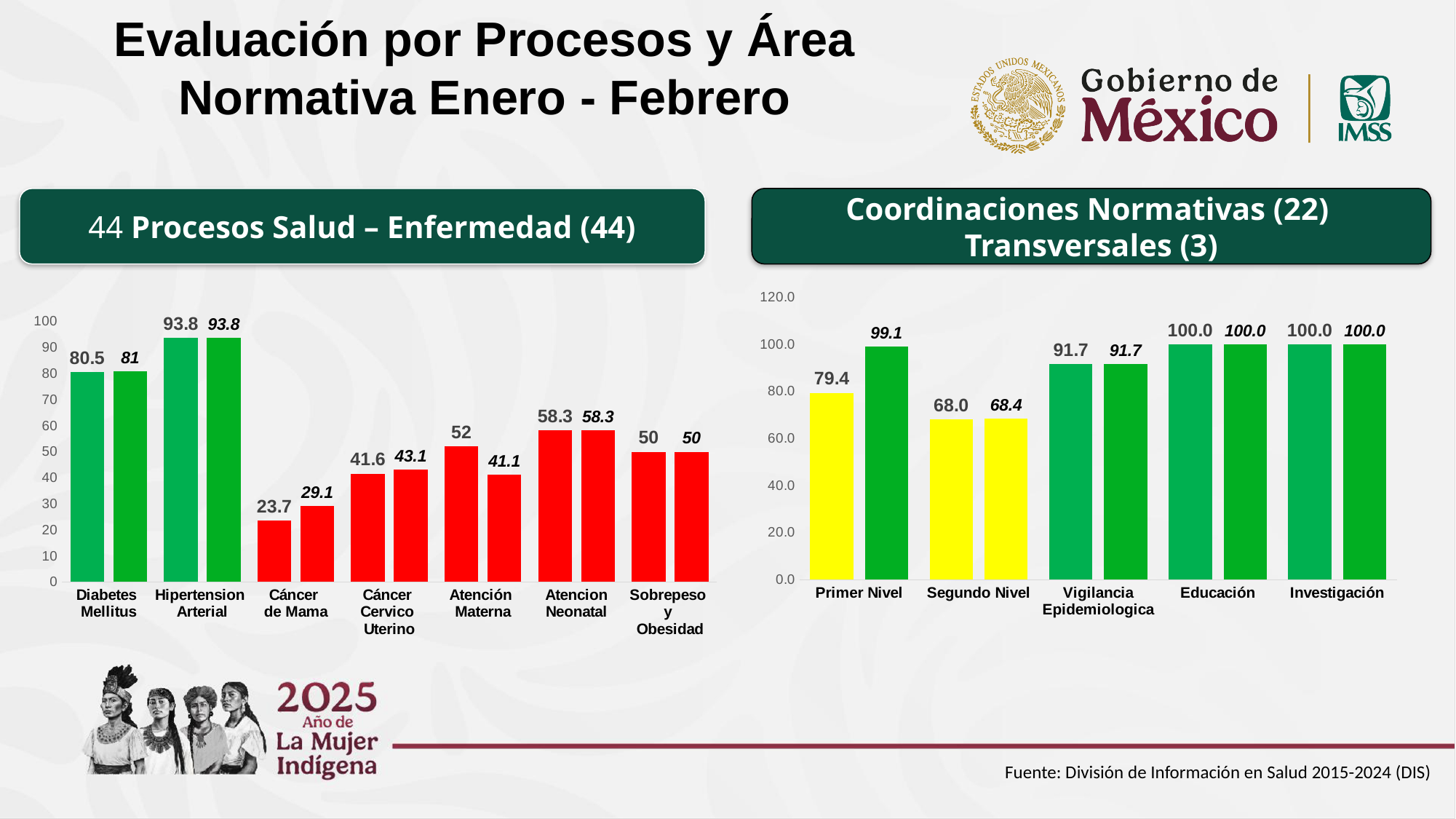
In the right chart (Coordinaciones Normativas), what is the difference between the two bars for Primer Nivel? 19.7 In the left chart (Procesos Salud – Enfermedad), what is the difference between the two bars for Atención Materna? 10.9 In the left chart (Procesos Salud – Enfermedad), which category has the lowest first-bar value? Cáncer de Mama In the right chart (Coordinaciones Normativas), what is the value of the second bar for Primer Nivel? 99.1 In the left chart (Procesos Salud – Enfermedad), which category has the highest values? Hipertension Arterial In the right chart (Coordinaciones Normativas), which category has the lowest values? Segundo Nivel What type of chart is used on the right side of the slide (Coordinaciones Normativas)? Bar chart In the right chart (Coordinaciones Normativas), is the first bar for Vigilancia Epidemiologica larger or smaller than the first bar for Primer Nivel? larger In the left chart (Procesos Salud – Enfermedad), what is the value of the second bar for Cáncer de Mama? 29.1 In the right chart (Coordinaciones Normativas), what is the value of the first bar for Segundo Nivel? 68.0 In the left chart (Procesos Salud – Enfermedad), what is the value of the first bar for Hipertension Arterial? 93.8 In the left chart (Procesos Salud – Enfermedad), how many categories are shown on the x axis? 7